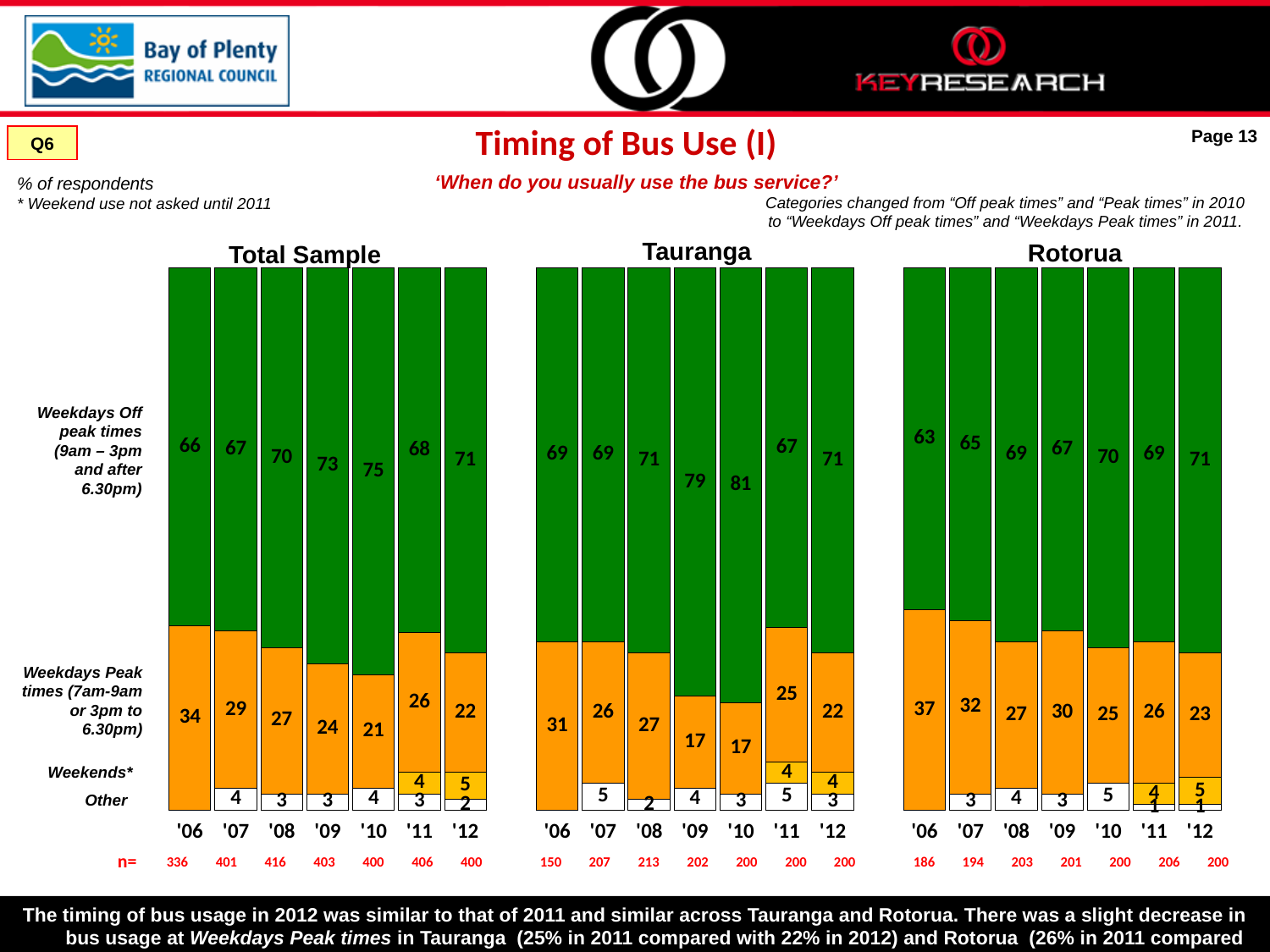
In the Total Sample chart, which year has the lowest value for Weekdays Peak times? '10 What type of chart is used for the Total Sample? Stacked bar chart In the Total Sample chart, what is the value for Weekends in '12? 5 In the Tauranga chart, what is the value for Weekdays Peak times in '09? 17 What is the n value shown for Tauranga in '06? 150 In the Total Sample chart, what is the value for Weekdays Off peak times in '06? 66 In the Rotorua chart, what is the value for Weekdays Peak times in '06? 37 In the Tauranga chart, which is larger: the Weekdays Peak times value in '11 or in '12? '11 In the Rotorua chart, what is the difference between the Weekdays Peak times values for '11 and '12? 3 In the Tauranga chart, which year has the highest value for Weekdays Off peak times? '10 How many years are shown on the x axis of the Rotorua chart? 7 In the Rotorua chart, what is the value for Other in '10? 5